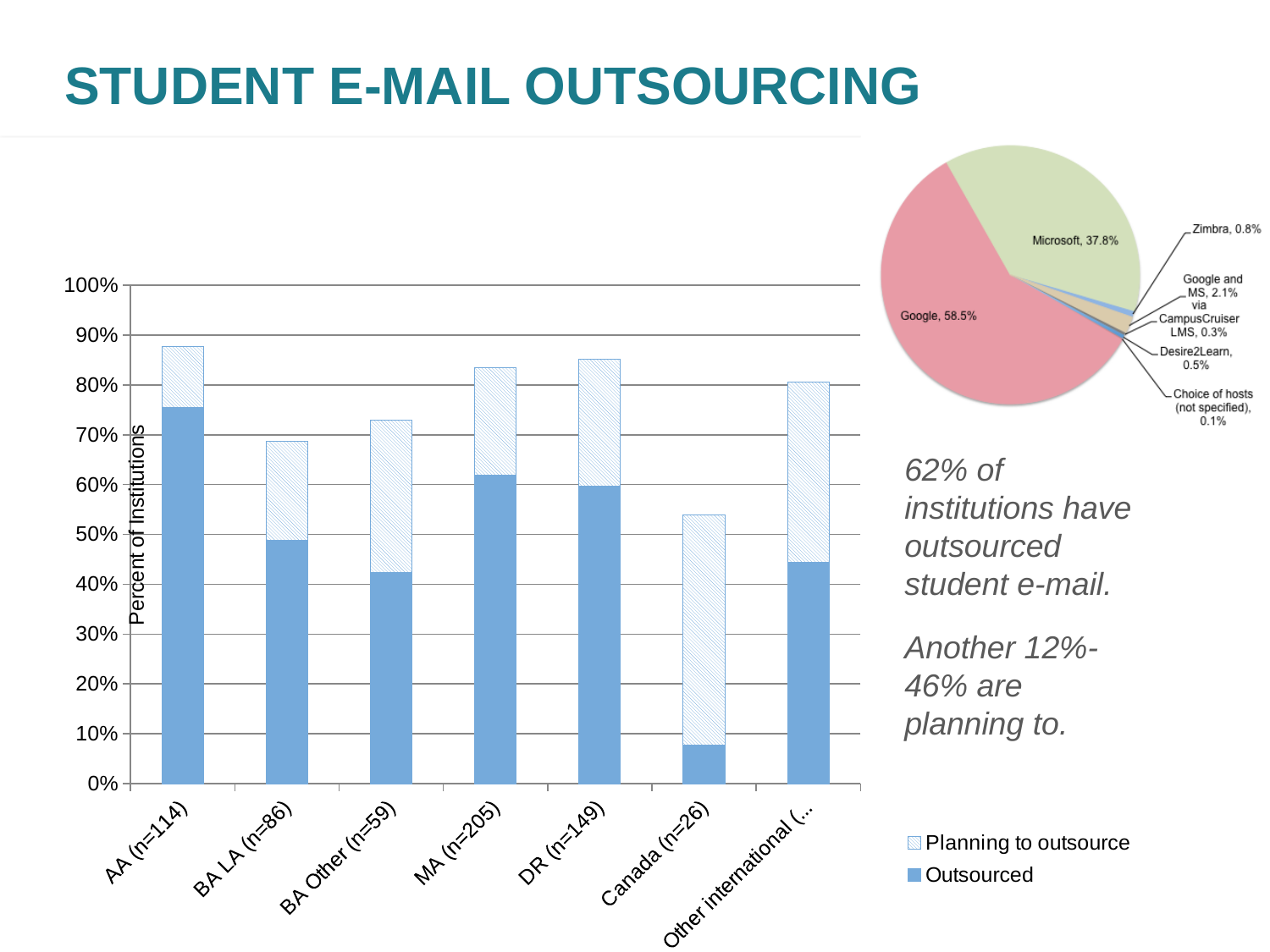
In the pie chart, what share is labelled for Microsoft? 37.8% In the bar chart on the left, which category has the lowest Outsourced value? Canada (n=26) In the pie chart, what share of institutions use Google for student e-mail? 58.5% In the pie chart, what share is labelled for Zimbra? 0.8% In the bar chart on the left, how many series does the legend list? 2 In the pie chart, which slice is the smallest? Choice of hosts (not specified) In the bar chart on the left, how many institution categories are shown on the x axis? 7 In the pie chart, which host has the largest slice? Google In the pie chart, how many percentage points larger is the Google slice than the Microsoft slice? 20.7 What kind of chart is the chart on the left showing Percent of Institutions? Stacked bar chart In the bar chart on the left, which has the larger Outsourced value, MA (n=205) or BA LA (n=86)? MA (n=205) In the bar chart on the left, is the Outsourced value for Canada (n=26) greater or less than 10%? less